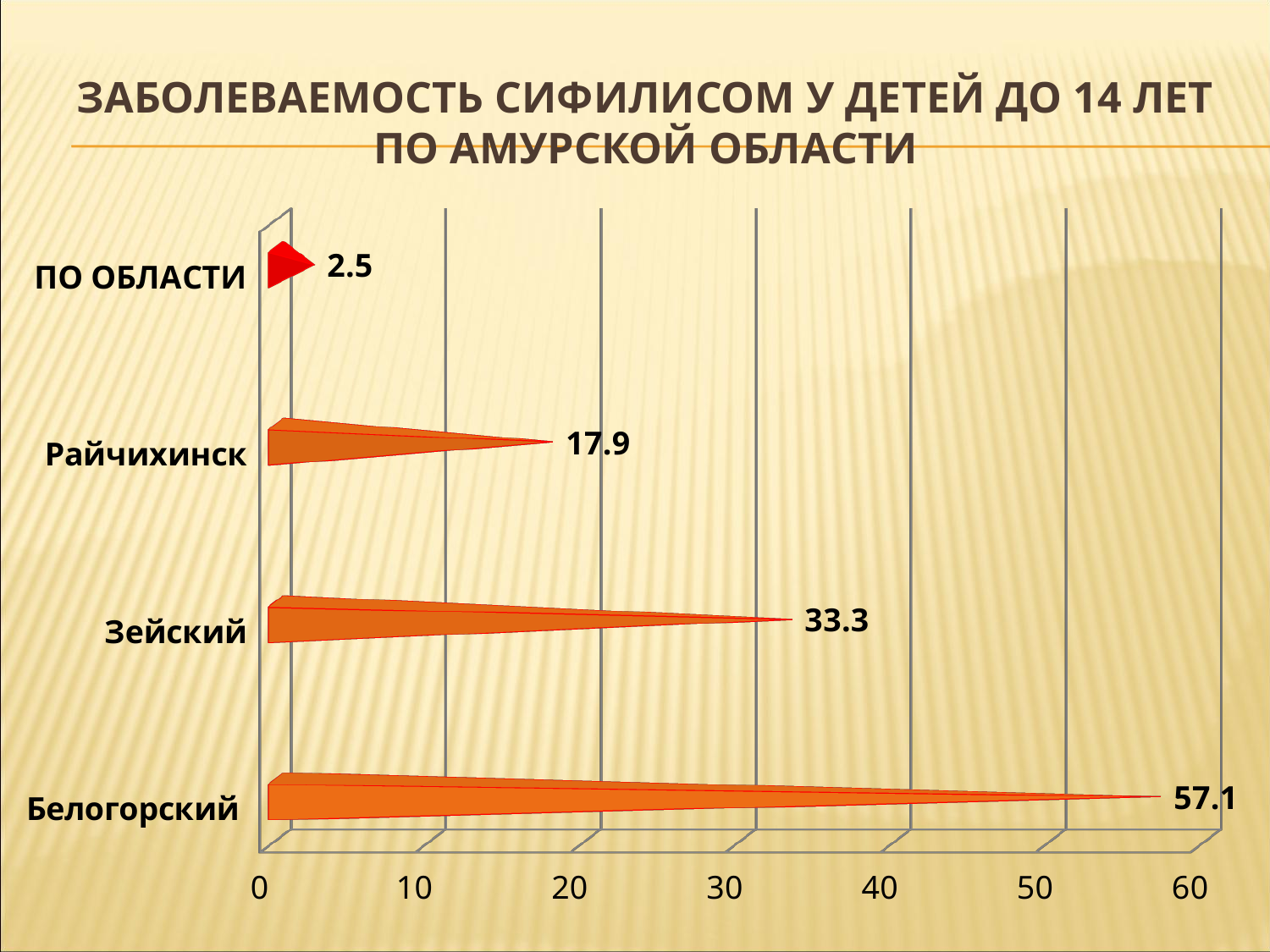
What kind of chart is shown on the slide? Bar chart What is the value for ПО ОБЛАСТИ? 2.5 Which category has the lowest value? ПО ОБЛАСТИ What is the difference between the values for Райчихинск and ПО ОБЛАСТИ? 15.4 Which is larger, the value for Зейский or the value for Райчихинск? Зейский What is the difference between the values for Белогорский and Зейский? 23.8 What is the value for Райчихинск? 17.9 What is the value for Белогорский? 57.1 What is the title of the chart? ЗАБОЛЕВАЕМОСТЬ СИФИЛИСОМ У ДЕТЕЙ ДО 14 ЛЕТ ПО АМУРСКОЙ ОБЛАСТИ Which category has the highest value? Белогорский How many categories are shown on the chart? 4 What is the value for Зейский? 33.3